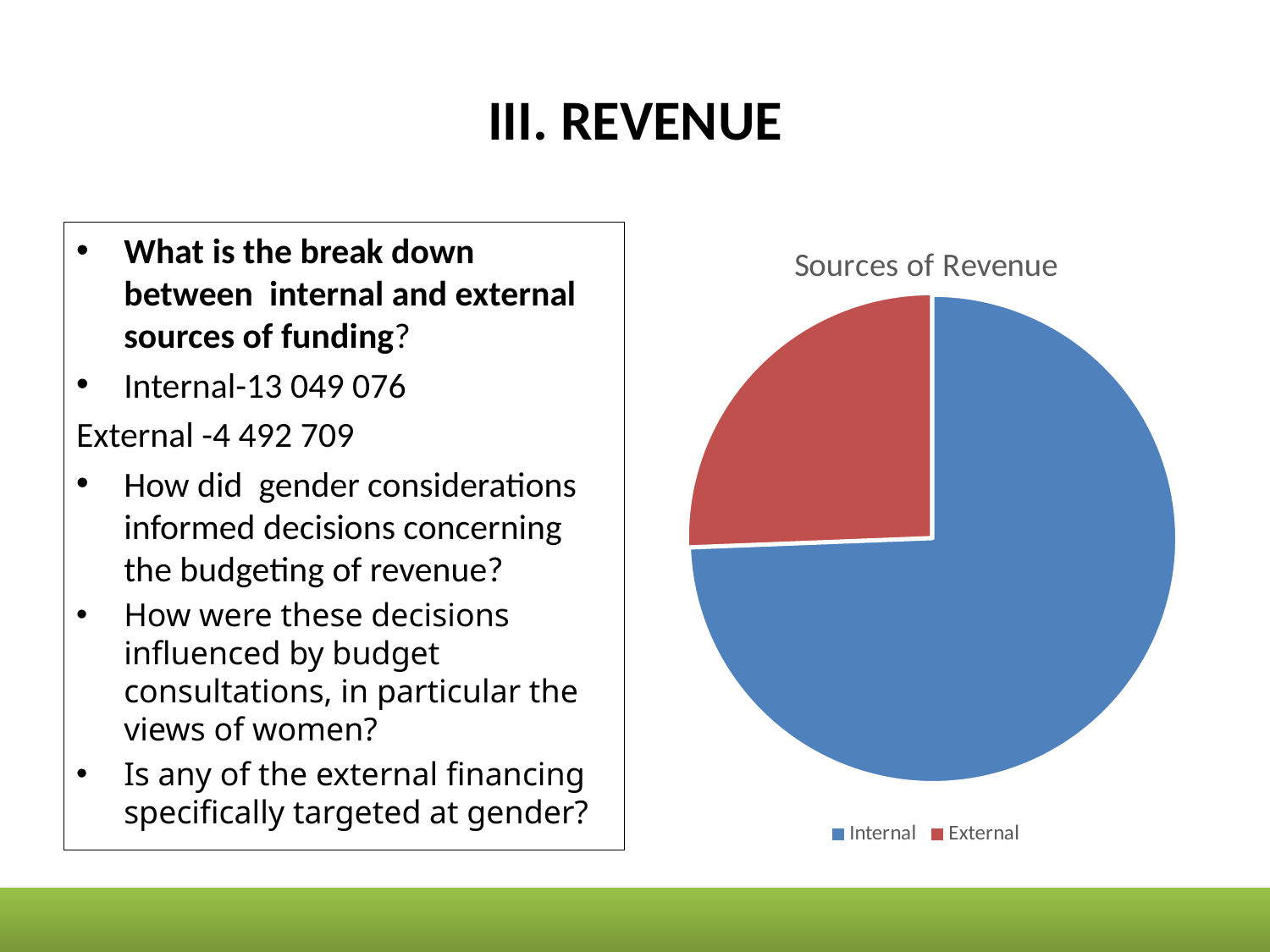
What kind of chart is shown on the slide? pie chart Which legend entry is shown in red? External Does the Internal slice take up more or less than half of the pie? more What is the title of the chart? Sources of Revenue Which is larger in the pie chart, Internal or External? Internal Which source of revenue has the largest slice in the pie chart? Internal How many entries does the chart legend list? 2 What colour represents Internal in the pie chart? blue Which source of revenue has the smallest slice in the pie chart? External How many slices does the pie chart have? 2